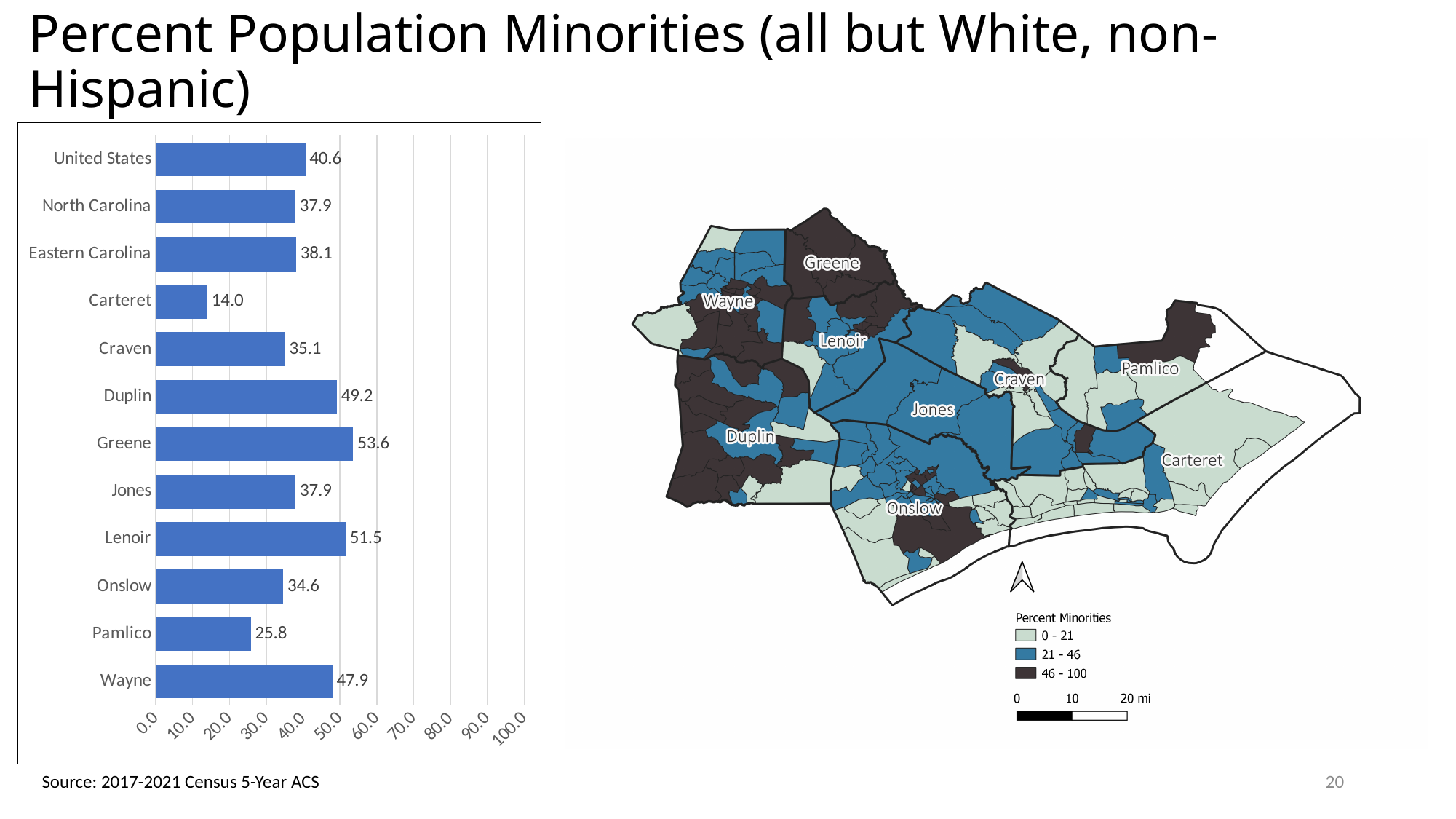
What is the value for Lenoir in the bar chart? 51.5 What is the value for Carteret in the bar chart? 14.0 How many categories are shown in the bar chart? 12 How many classes does the map legend 'Percent Minorities' list? 3 Which category has the highest value in the bar chart? Greene In the bar chart, which is larger, the value for Duplin or the value for Craven? Duplin What is the value for the United States in the bar chart? 40.6 What is the difference between the values for Wayne and Pamlico in the bar chart? 22.1 Is the value for Onslow in the bar chart greater or less than 40.0? less Which category has the lowest value in the bar chart? Carteret What kind of chart is shown on the left of the slide? bar chart What is the difference between the values for Greene and Carteret in the bar chart? 39.6